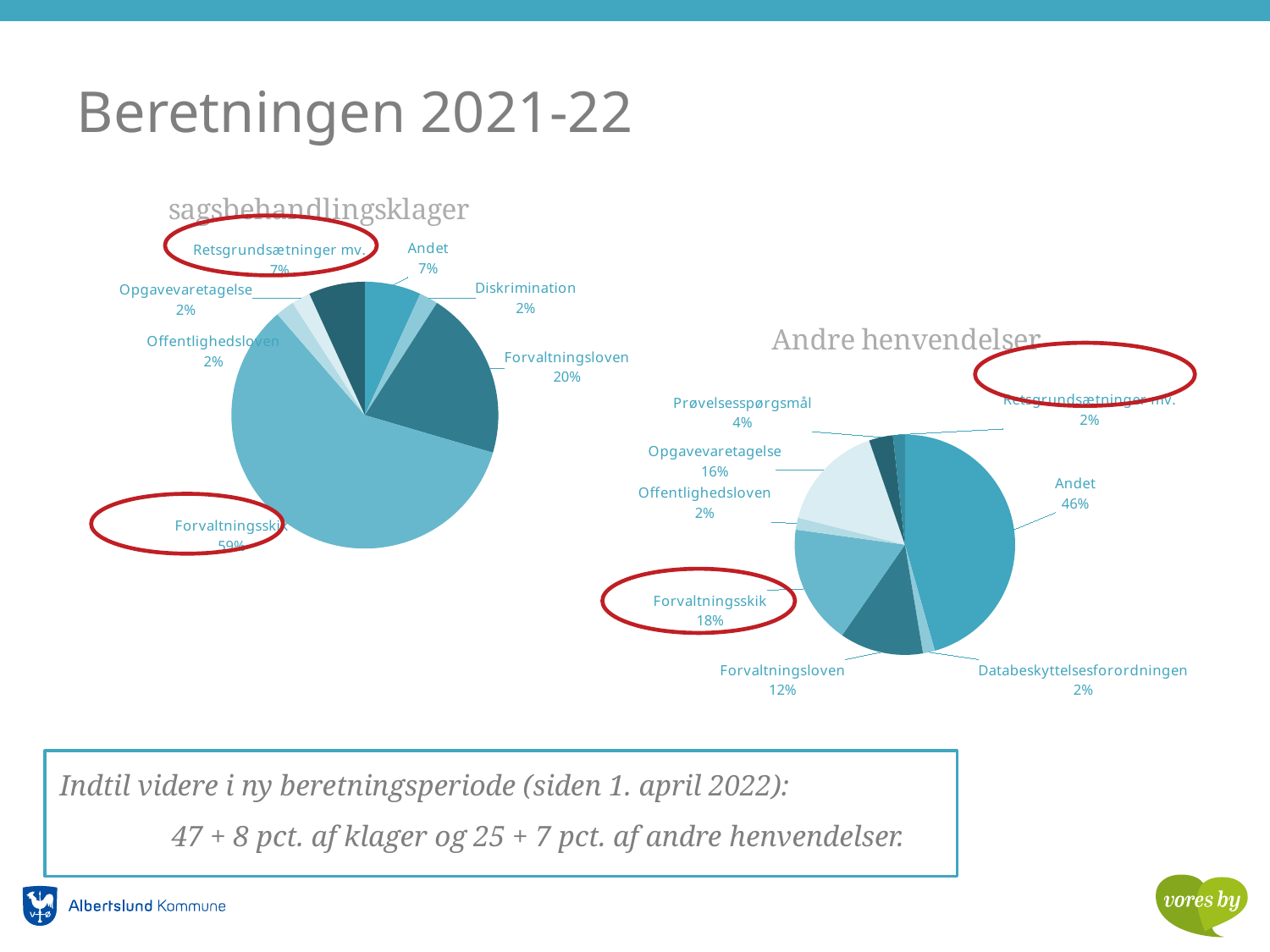
In the 'sagsbehandlingsklager' chart, which category has the largest share? Forvaltningsskik In the 'Andre henvendelser' chart, what is the difference between the shares of Andet and Forvaltningsskik? 28 percentage points In the 'Andre henvendelser' chart, which category has the largest share? Andet In the 'sagsbehandlingsklager' chart, what share does Forvaltningsloven have? 20% In the 'Andre henvendelser' chart, which is larger: Forvaltningsskik or Opgavevaretagelse? Forvaltningsskik What type of chart is used for 'Andre henvendelser'? Pie chart How many categories are shown in the 'Andre henvendelser' chart? 8 In the 'Andre henvendelser' chart, what share does Opgavevaretagelse have? 16% In the 'sagsbehandlingsklager' chart, what is the difference between the shares of Forvaltningsloven and Retsgrundsætninger mv.? 13 percentage points In the 'sagsbehandlingsklager' chart, what share does Andet have? 7% In the 'Andre henvendelser' chart, what share does Forvaltningsloven have? 12% How many categories are shown in the 'sagsbehandlingsklager' chart? 7